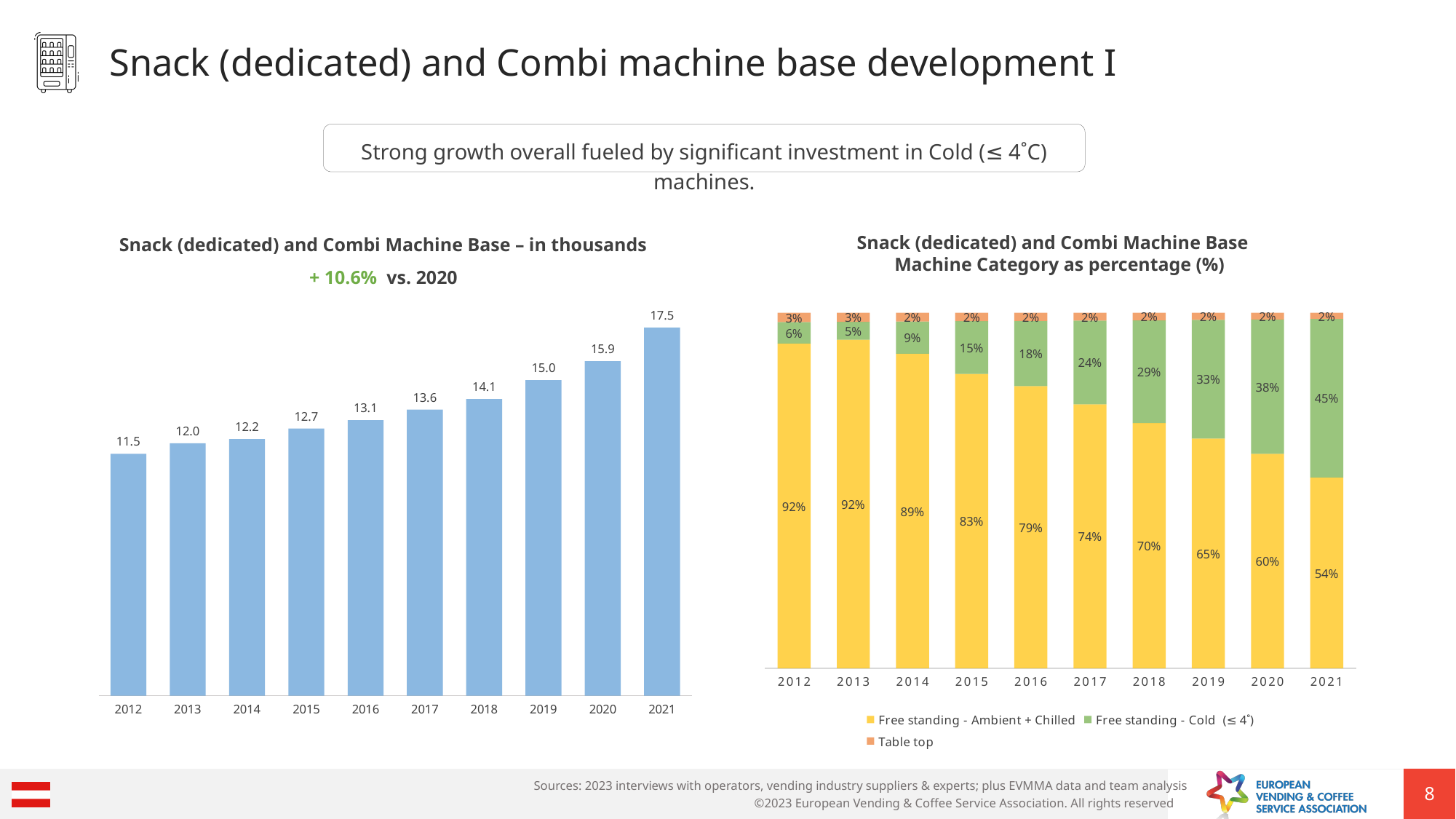
In the left chart (Snack (dedicated) and Combi Machine Base – in thousands), how many years are shown? 10 What kind of chart is the left chart (Snack (dedicated) and Combi Machine Base – in thousands)? bar chart In the left chart (Snack (dedicated) and Combi Machine Base – in thousands), what is the value for 2016? 13.1 In the right chart (Machine Category as percentage), what is the share of Free standing - Cold (≤ 4°) in 2021? 45% In the left chart (Snack (dedicated) and Combi Machine Base – in thousands), what is the value for 2021? 17.5 In the left chart (Snack (dedicated) and Combi Machine Base – in thousands), do the values rise or fall from 2012 to 2021? rise In the right chart (Machine Category as percentage), what is the share of Free standing - Ambient + Chilled in 2015? 83% In the right chart (Machine Category as percentage), which is larger in 2019: Free standing - Ambient + Chilled or Free standing - Cold (≤ 4°)? Free standing - Ambient + Chilled In the left chart (Snack (dedicated) and Combi Machine Base – in thousands), which year has the lowest value? 2012 In the right chart (Machine Category as percentage), what is the share of Table top in 2012? 3% In the right chart (Machine Category as percentage), how many series does the legend list? 3 In the left chart (Snack (dedicated) and Combi Machine Base – in thousands), what is the difference between the 2021 and 2020 values? 1.6